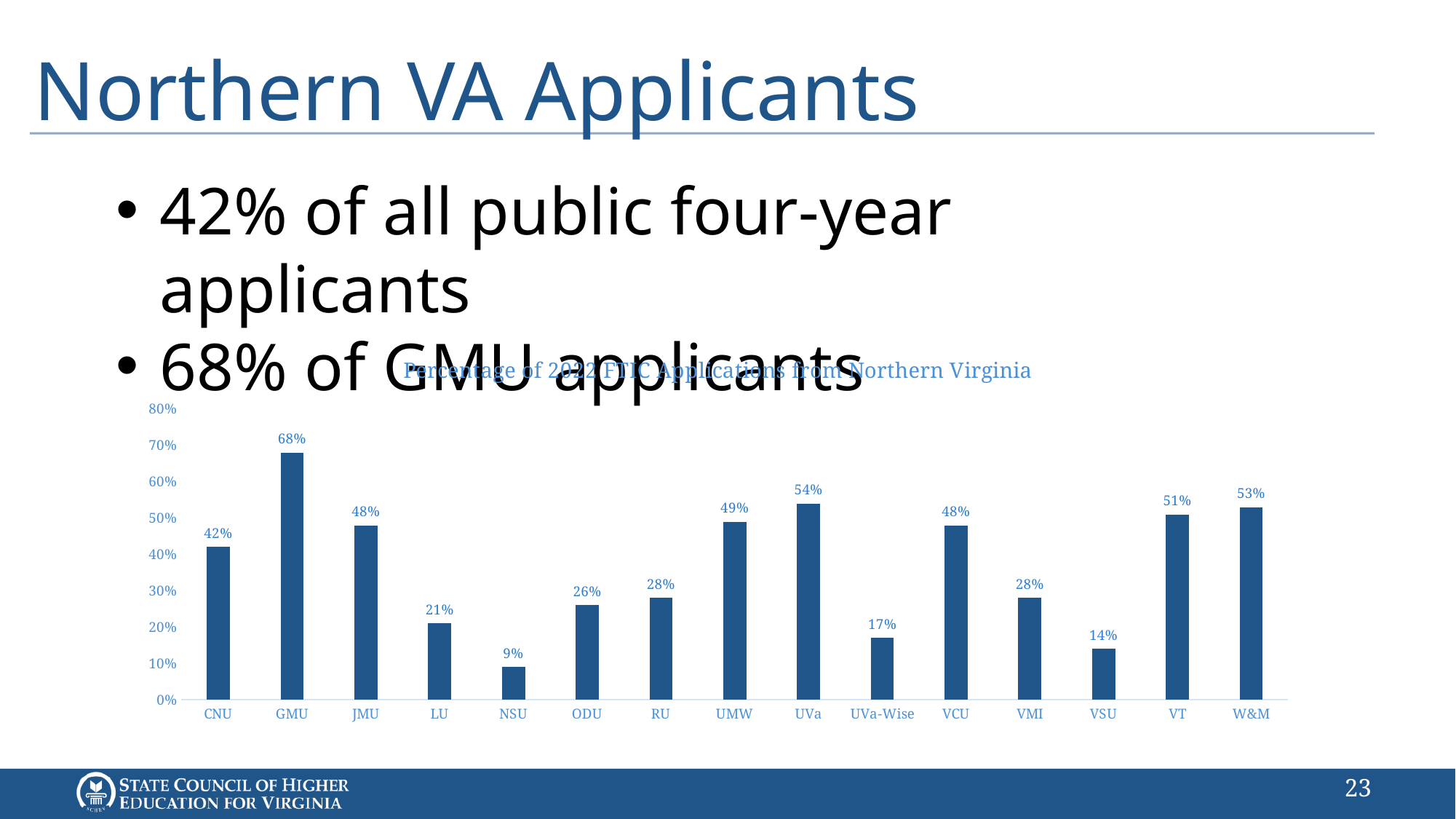
What is the title of the chart? Percentage of 2022 FTIC Applications from Northern Virginia Is the value for ODU greater or less than 30%? less What is the value for UVa-Wise? 17% Which is larger, the value for VT or the value for LU? VT What is the difference between the values for UVa and VSU? 40% What is the value for GMU? 68% What kind of chart is shown on the slide? bar chart How many institutions are shown on the x axis of the chart? 15 What is the difference between the values for GMU and CNU? 26% Which institution has the lowest percentage of 2022 FTIC applications from Northern Virginia? NSU Which institution has the highest percentage of 2022 FTIC applications from Northern Virginia? GMU What is the value for W&M? 53%